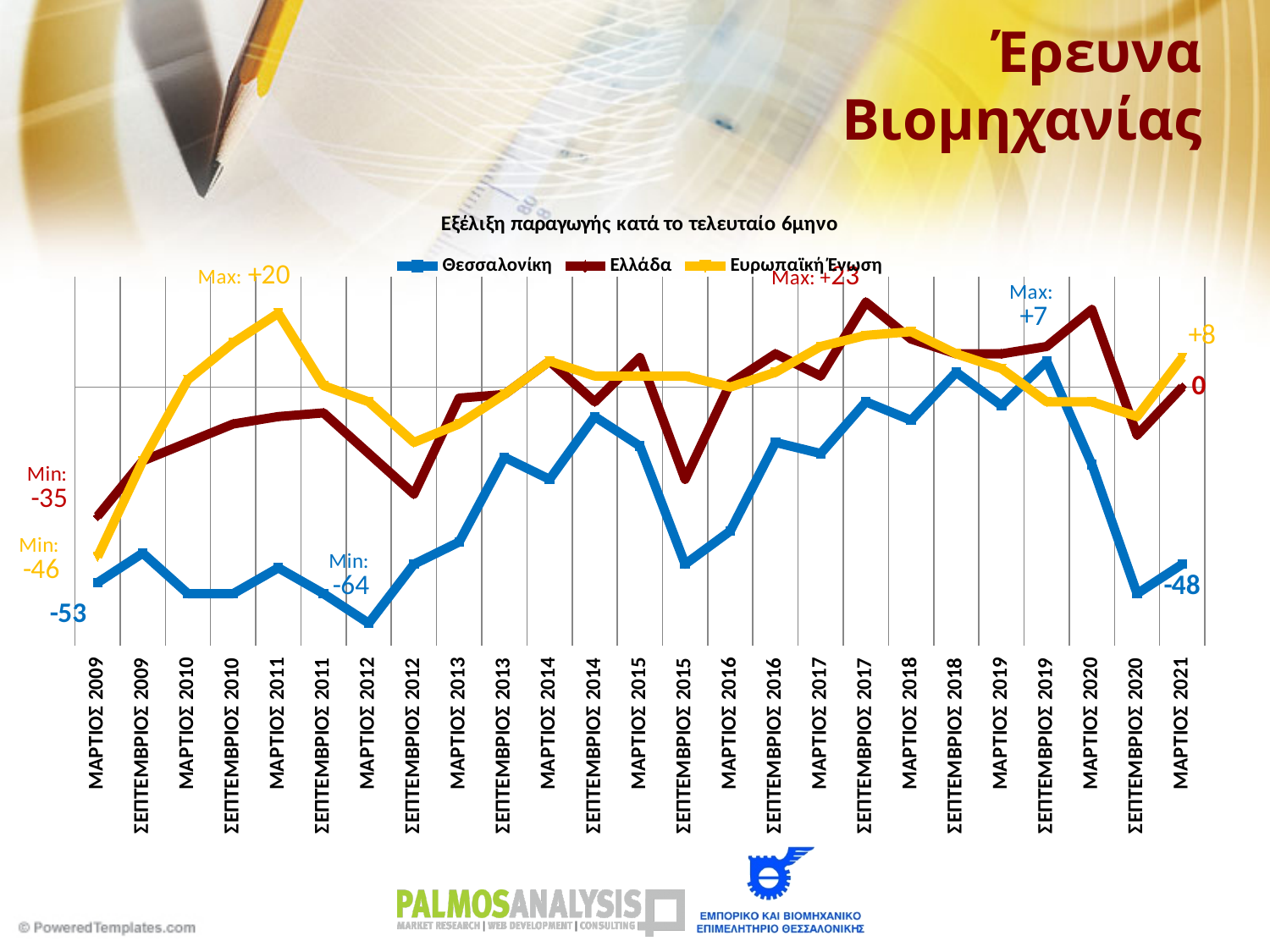
What is the minimum value reached by the Θεσσαλονίκη series? -64 What is the value for Θεσσαλονίκη in ΜΑΡΤΙΟΣ 2009? -53 In ΜΑΡΤΙΟΣ 2021, which series has the higher value, Ελλάδα or Θεσσαλονίκη? Ελλάδα In which period does the Ευρωπαϊκή Ένωση series reach its maximum of +20? ΜΑΡΤΙΟΣ 2011 Does the Θεσσαλονίκη series rise or fall between ΣΕΠΤΕΜΒΡΙΟΣ 2019 and ΣΕΠΤΕΜΒΡΙΟΣ 2020? fall What is the difference between the maximum (+23) and minimum (-35) values of the Ελλάδα series? 58 What is the maximum value reached by the Ελλάδα series, and in which period? +23, ΣΕΠΤΕΜΒΡΙΟΣ 2017 What is the value for Ευρωπαϊκή Ένωση in ΜΑΡΤΙΟΣ 2021? +8 What kind of chart is shown on the slide? line chart What is the value for Θεσσαλονίκη in ΜΑΡΤΙΟΣ 2021? -48 What is the value for Ελλάδα in ΜΑΡΤΙΟΣ 2021? 0 How many series does the legend list? 3